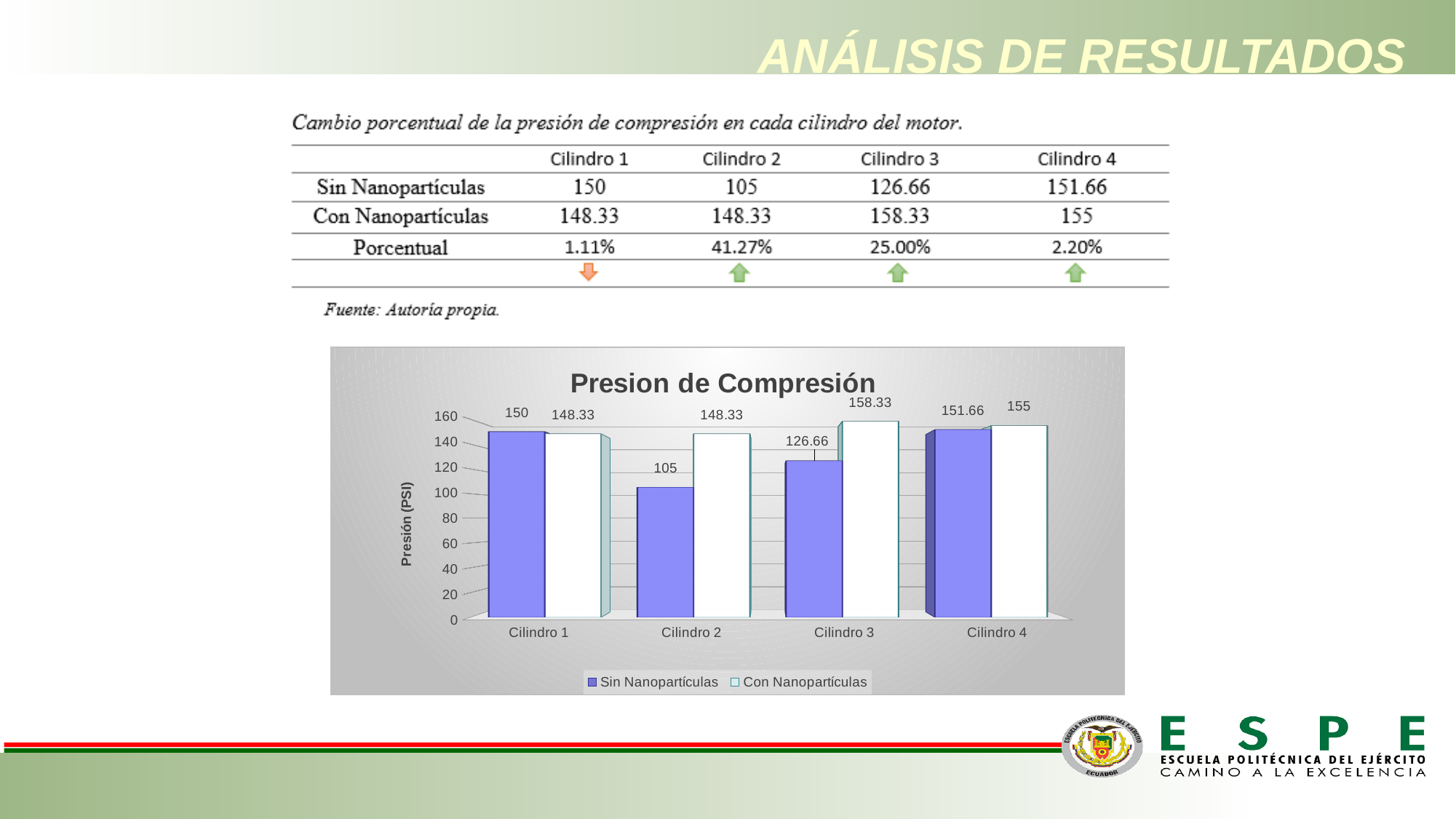
Which cylinder has the lowest value in the Sin Nanopartículas series? Cilindro 2 Is the Sin Nanopartículas value for Cilindro 3 greater or less than 120? greater What is the title of the chart? Presion de Compresión Which cylinder has the highest value in the Con Nanopartículas series? Cilindro 3 How many cylinders are shown on the x axis of the chart? 4 What is the value for Cilindro 2 in the Sin Nanopartículas series? 105 For Cilindro 3, which series has the larger value, Sin Nanopartículas or Con Nanopartículas? Con Nanopartículas What is the difference between the Con Nanopartículas and Sin Nanopartículas values for Cilindro 2? 43.33 What kind of chart is shown on the slide? Bar chart What is the value for Cilindro 3 in the Con Nanopartículas series? 158.33 How many series does the chart legend list? 2 What is the value for Cilindro 4 in the Sin Nanopartículas series? 151.66